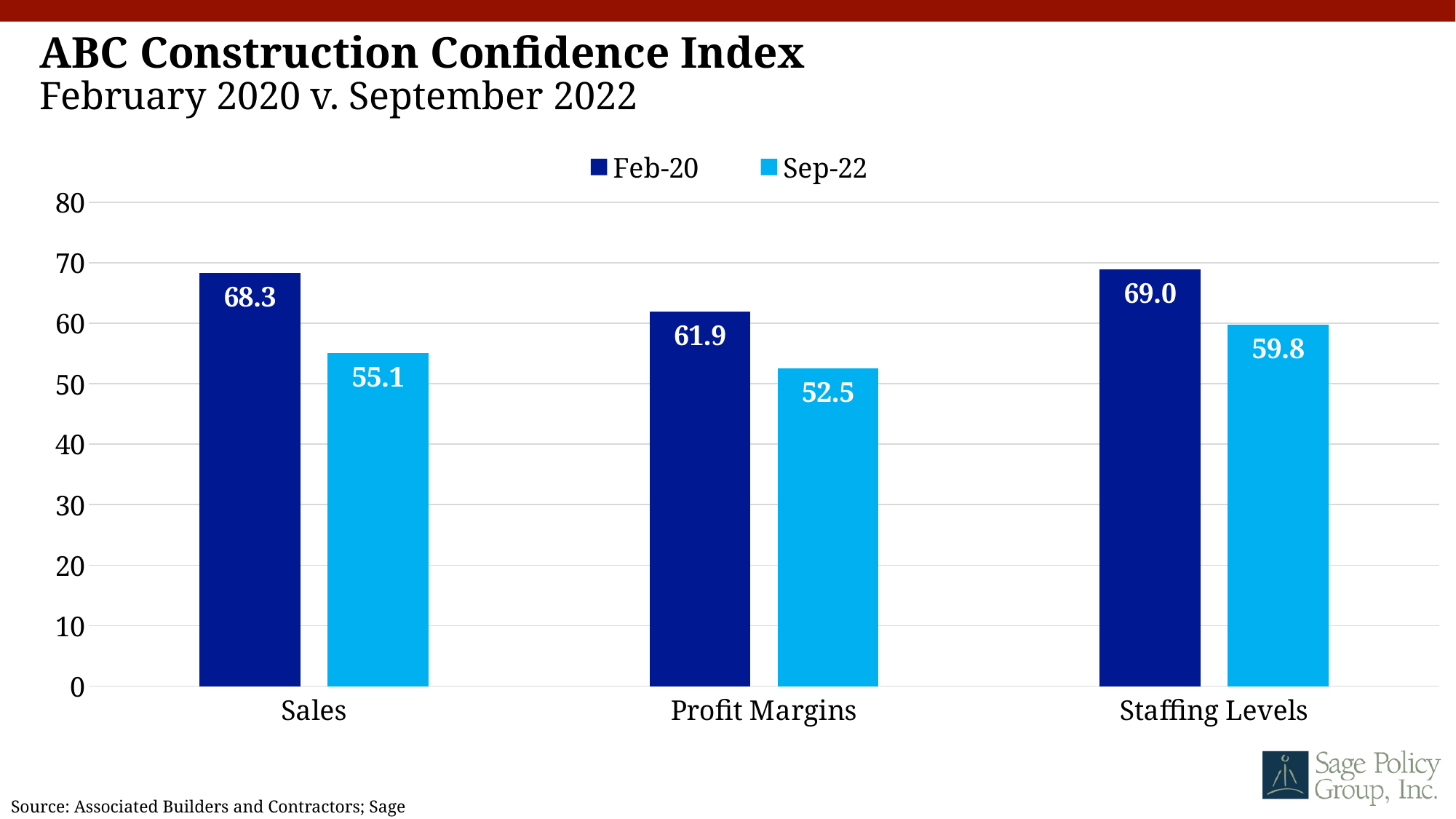
Which is larger, the Sep-22 value for Sales or the Sep-22 value for Staffing Levels? Staffing Levels What is the Feb-20 value for Sales? 68.3 Is the Feb-20 value for Profit Margins greater or less than 60? greater What kind of chart is shown on the slide? bar chart How many series does the legend list? 2 How many categories are shown on the x axis? 3 What is the difference between the Feb-20 and Sep-22 values for Sales? 13.2 What is the difference between the Feb-20 and Sep-22 values for Profit Margins? 9.4 Which category has the highest Feb-20 value? Staffing Levels What is the Sep-22 value for Profit Margins? 52.5 What is the Sep-22 value for Staffing Levels? 59.8 Which category has the lowest Sep-22 value? Profit Margins